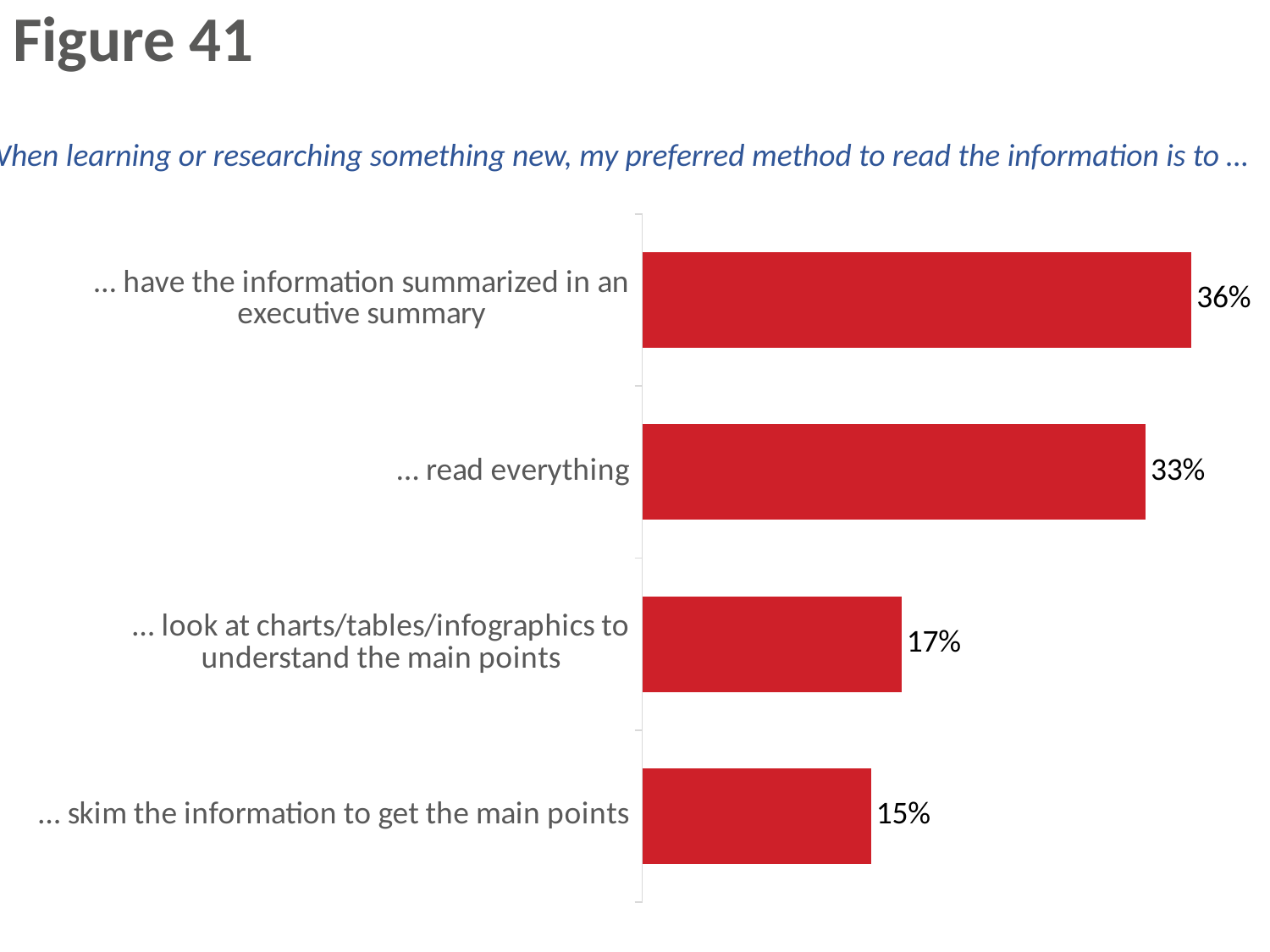
What percentage of respondents prefer to skim the information to get the main points? 15% What is the difference in percentage points between 'read everything' and 'skim the information to get the main points'? 18 How many reading methods are shown in the chart? 4 Which reading method has the lowest percentage? ... skim the information to get the main points What is the difference in percentage points between 'have the information summarized in an executive summary' and 'read everything'? 3 What percentage of respondents prefer to have the information summarized in an executive summary? 36% What percentage of respondents prefer to read everything? 33% Which is larger: the percentage for 'look at charts/tables/infographics to understand the main points' or for 'skim the information to get the main points'? ... look at charts/tables/infographics to understand the main points Which reading method has the highest percentage? ... have the information summarized in an executive summary What colour are the bars in the chart? Red What percentage of respondents prefer to look at charts/tables/infographics to understand the main points? 17% What type of chart is shown on the slide? Bar chart